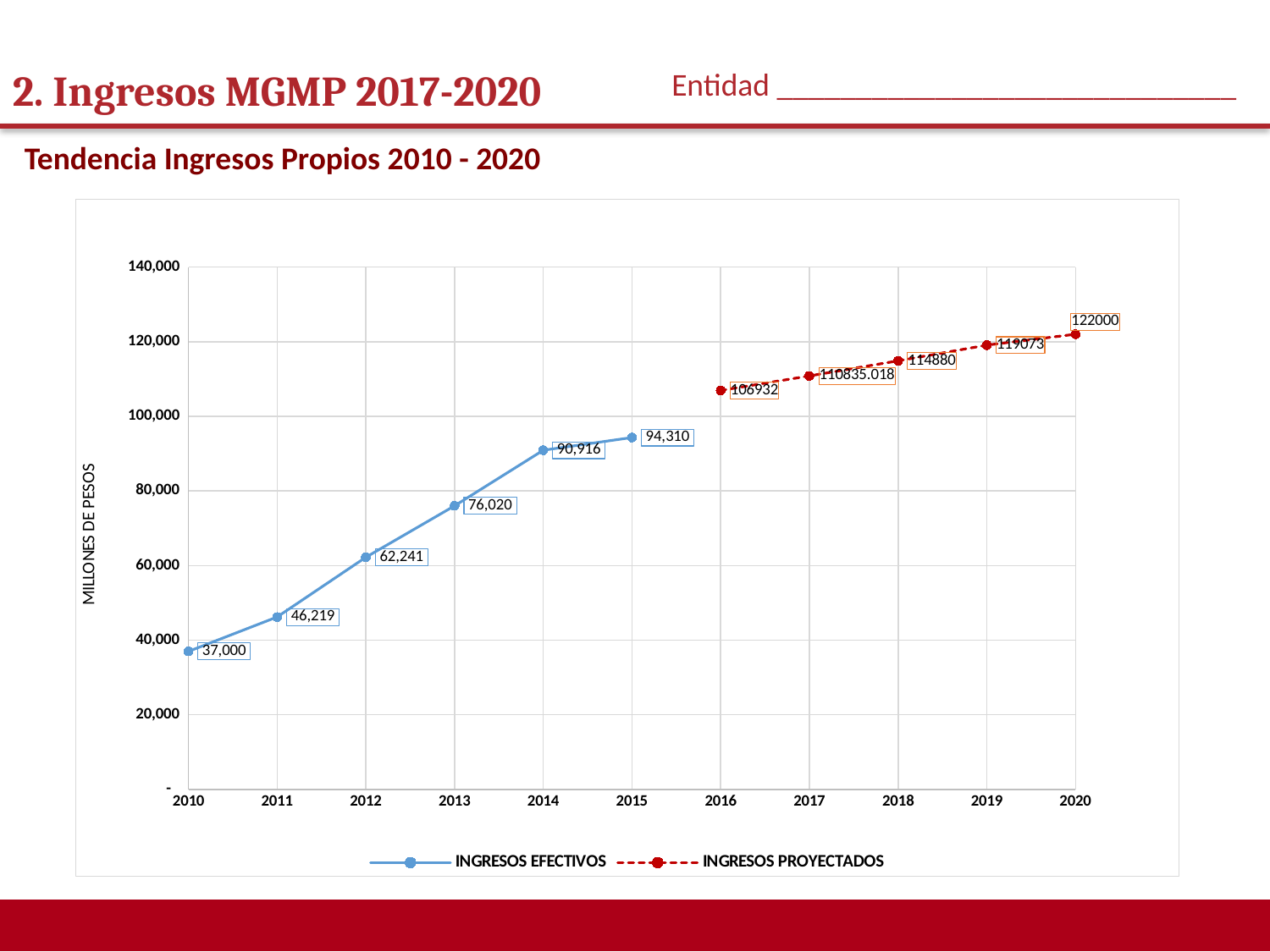
Do the values rise or fall from 2010 to 2020? rise Which year has the lowest value of INGRESOS PROYECTADOS? 2016 What is the value of INGRESOS PROYECTADOS for 2017? 110835.018 What is the value of INGRESOS EFECTIVOS for 2010? 37,000 Is the value for 2018 greater or less than 100,000? greater Which is larger: the INGRESOS EFECTIVOS value for 2012 or for 2011? 2012 What is the value of INGRESOS EFECTIVOS for 2013? 76,020 Which year has the highest value of INGRESOS EFECTIVOS? 2015 How many series does the legend list? 2 What kind of chart is shown on the slide? line chart What is the difference between the INGRESOS EFECTIVOS values for 2015 and 2014? 3,394 What is the value of INGRESOS PROYECTADOS for 2020? 122000